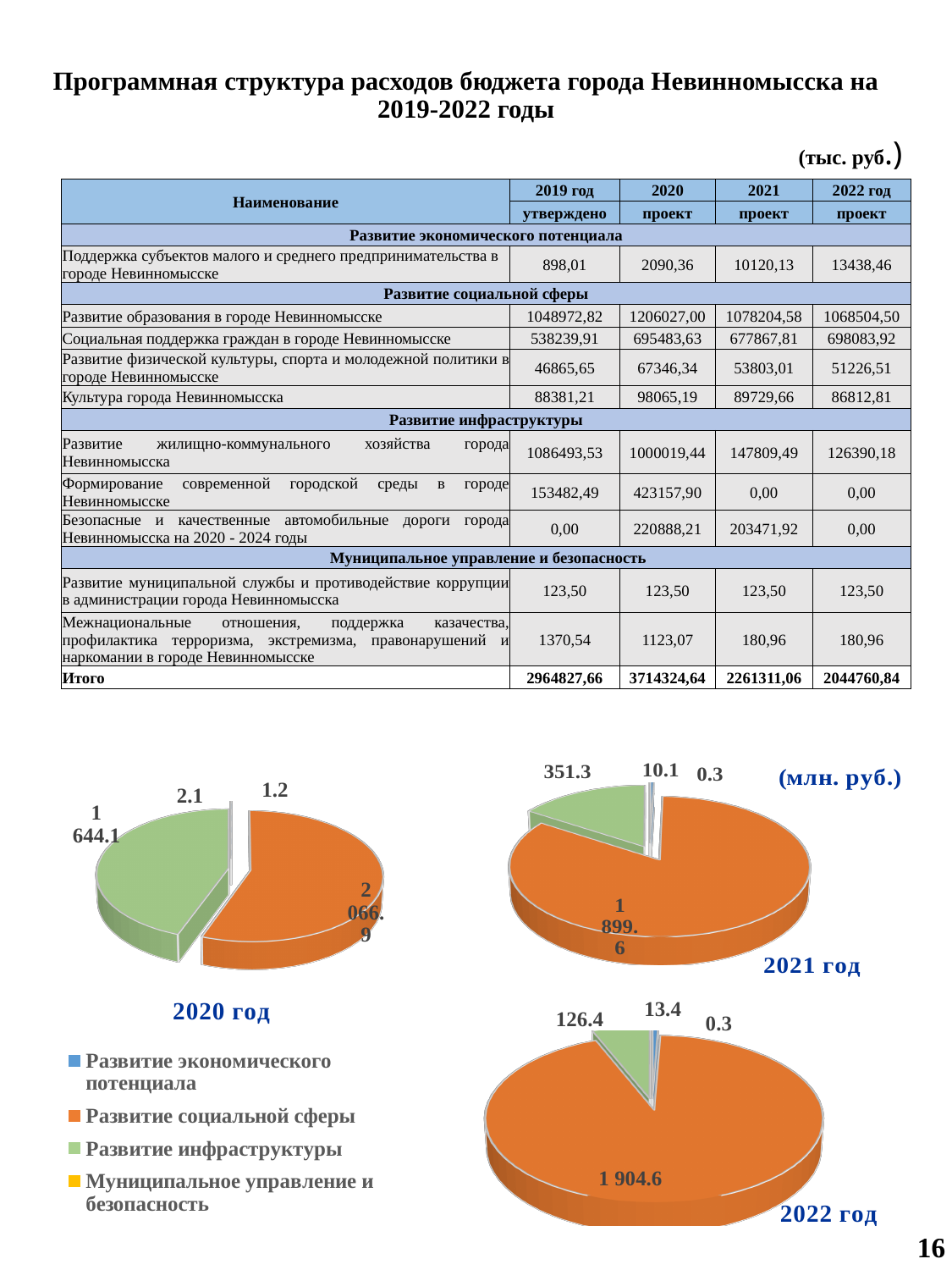
In the 2020 год chart, what is the difference between the Развитие социальной сферы slice and the Развитие инфраструктуры slice? 422.8 In the 2022 год chart, what is the difference between the Развитие социальной сферы slice and the Развитие инфраструктуры slice? 1 778.2 In the 2021 год chart, which category has the smallest slice? Муниципальное управление и безопасность How many series does the legend list for the pie charts? 4 How many slices does the 2021 год pie chart have? 4 In the 2022 год chart, what is the value of the Развитие инфраструктуры slice? 126.4 In the 2022 год chart, which category has the largest slice? Развитие социальной сферы In the 2021 год chart, what is the value of the Развитие социальной сферы slice? 1 899.6 In what units are the values on the pie charts given? млн. руб. In the 2020 год chart, what is the value of the Развитие социальной сферы slice? 2 066.9 Which is larger: the Развитие инфраструктуры slice in the 2021 год chart or in the 2022 год chart? 2021 год What kind of chart is used for the 2020 год, 2021 год and 2022 год charts? Pie chart